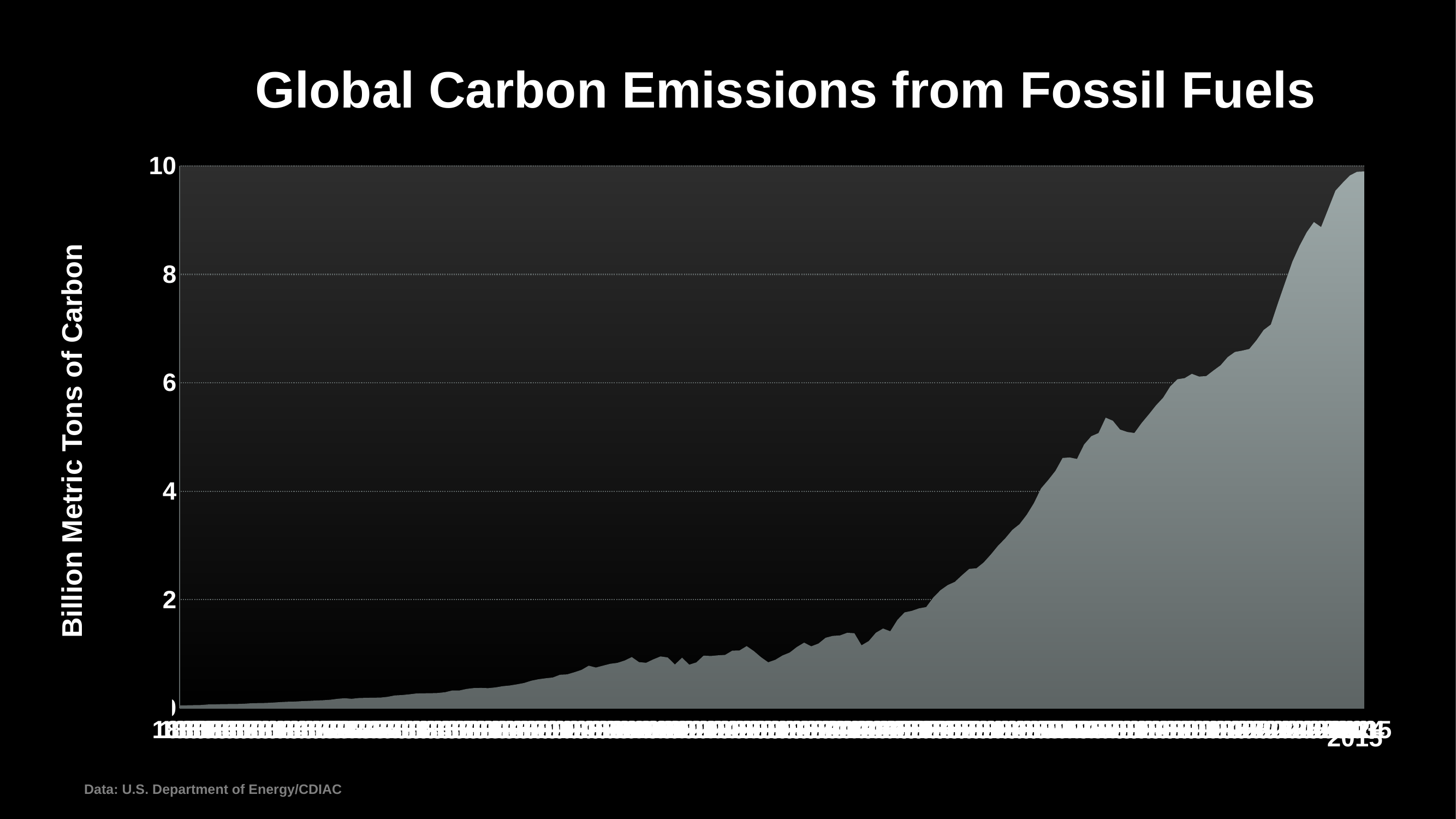
Do the values generally rise or fall along the x axis? rise Is the value for 2015 greater or less than 8? greater What is the title of the chart? Global Carbon Emissions from Fossil Fuels What kind of chart is shown on the slide? area chart Which end of the x axis has the higher emissions value, the left end or the right end (2015)? the right end (2015) Is the value for 2015 greater or less than 6? greater Is the value at the left end of the chart greater or less than 2? less What is the label on the vertical axis? Billion Metric Tons of Carbon What is the highest tick value shown on the vertical axis? 10